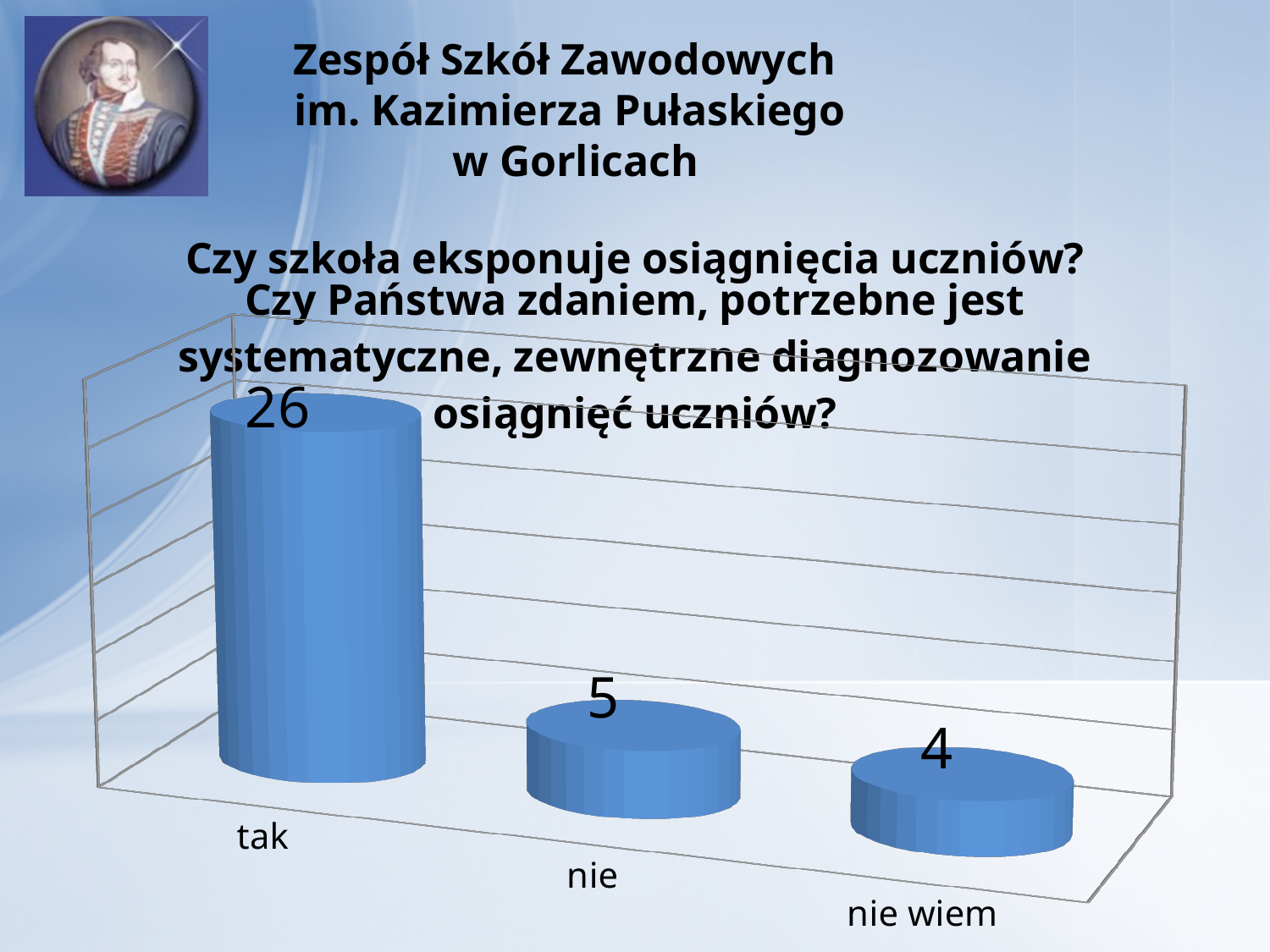
What is the value for "tak"? 26 What is the total of the three values shown in the chart? 35 What is the value for "nie wiem"? 4 Which category has the lowest value? nie wiem What is the difference between the values for "nie" and "nie wiem"? 1 What is the value for "nie"? 5 What is the difference between the values for "tak" and "nie"? 21 How many categories are shown in the chart? 3 Do the values rise or fall from left to right across the categories? fall What kind of chart is shown on the slide? bar chart Which category has the highest value? tak Which is larger, the value for "tak" or the value for "nie wiem"? tak